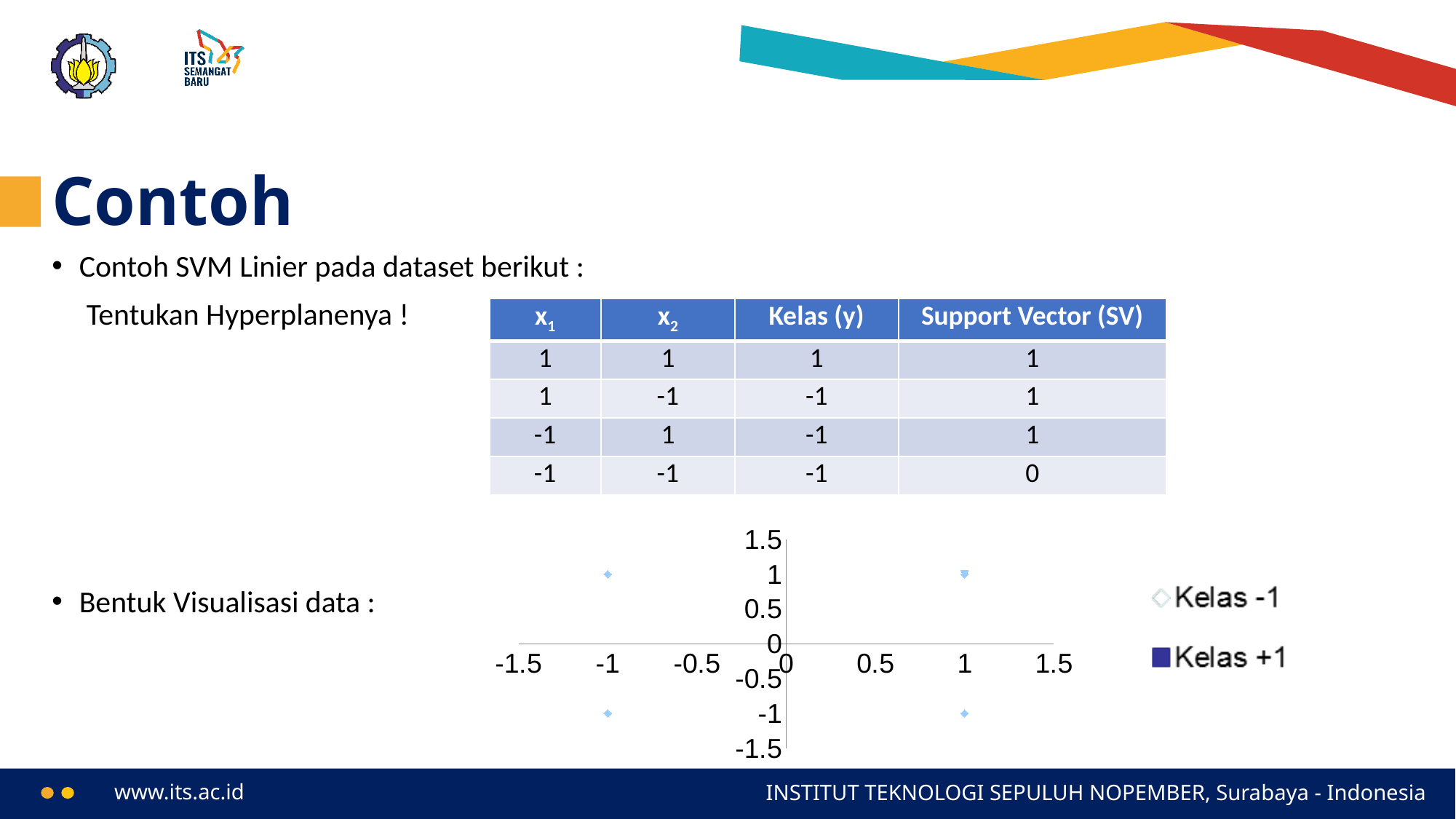
How many points in the scatter chart have a y value of 1? 2 In the scatter chart, what is the y-coordinate of the point in the upper-right quadrant? 1 How many points in the scatter chart have an x value of -1? 2 How many data points are plotted in the scatter chart? 4 In the scatter chart, is the x value of the lower-left point greater or less than -0.5? less In the scatter chart, what is the x-coordinate of the point in the upper-left quadrant? -1 What are the two legend entries of the scatter chart? Kelas -1, Kelas +1 In the scatter chart, is the y value of the upper-right point greater or less than 0.5? greater What is the highest tick value shown on the x axis of the scatter chart? 1.5 What kind of chart is shown under "Bentuk Visualisasi data"? scatter chart In the scatter chart, what is the y-coordinate of the point in the lower-right quadrant? -1 How many series does the legend of the scatter chart list? 2